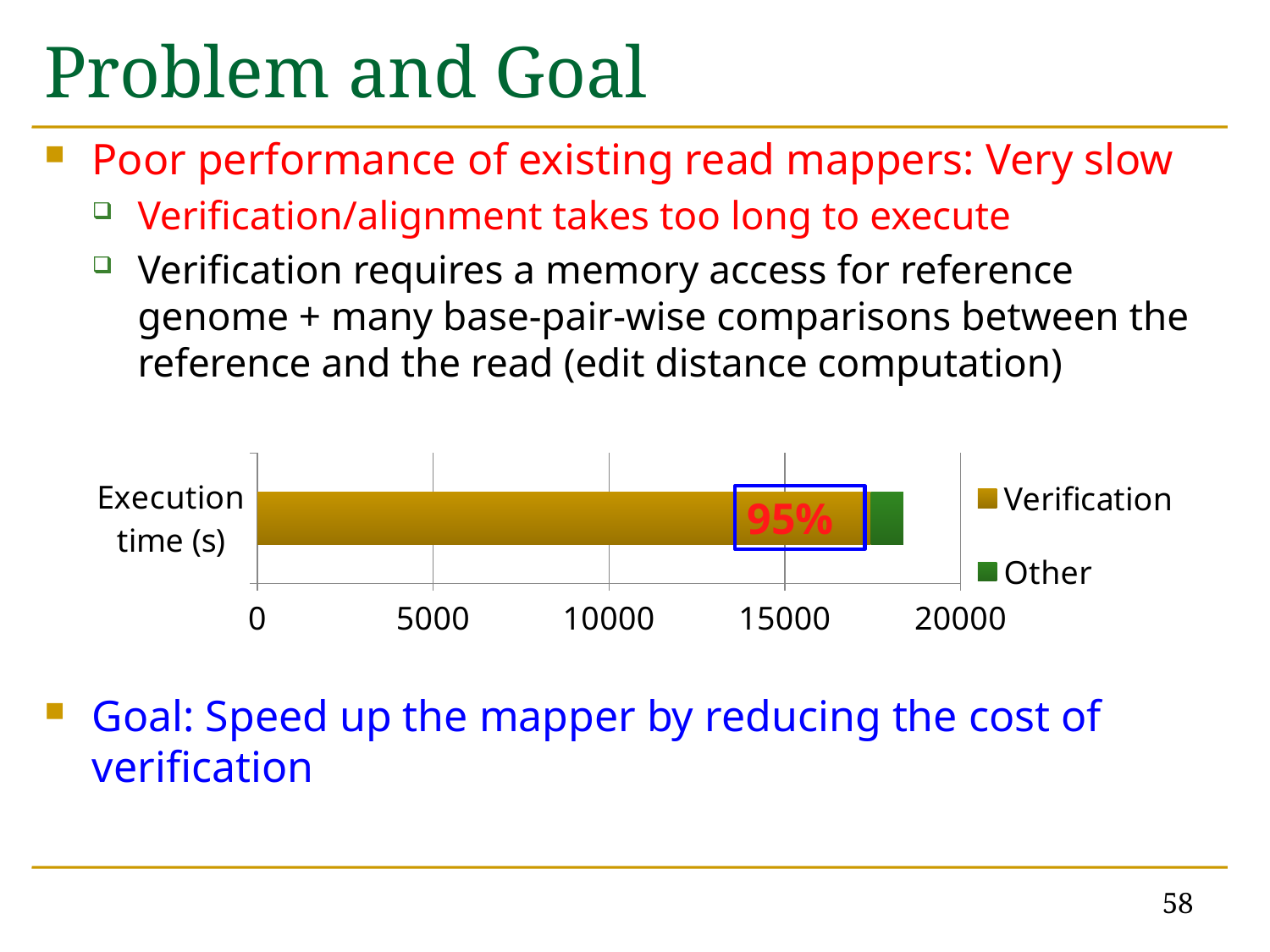
Which series takes up the larger portion of the Execution time bar, Verification or Other? Verification Is the Verification portion of the Execution time bar greater or less than 20000? less Is the Verification portion of the Execution time bar greater or less than 15000? greater Is the Other portion of the Execution time bar greater or less than 5000? less What kind of chart is shown on the slide? bar chart What are the two series named in the chart legend? Verification and Other What percentage is printed on the Verification portion of the bar? 95% How many categories are plotted on the chart's vertical axis? 1 What is the highest value shown on the chart's horizontal axis? 20000 How many series does the chart legend list? 2 What is the label of the single category on the chart? Execution time (s)